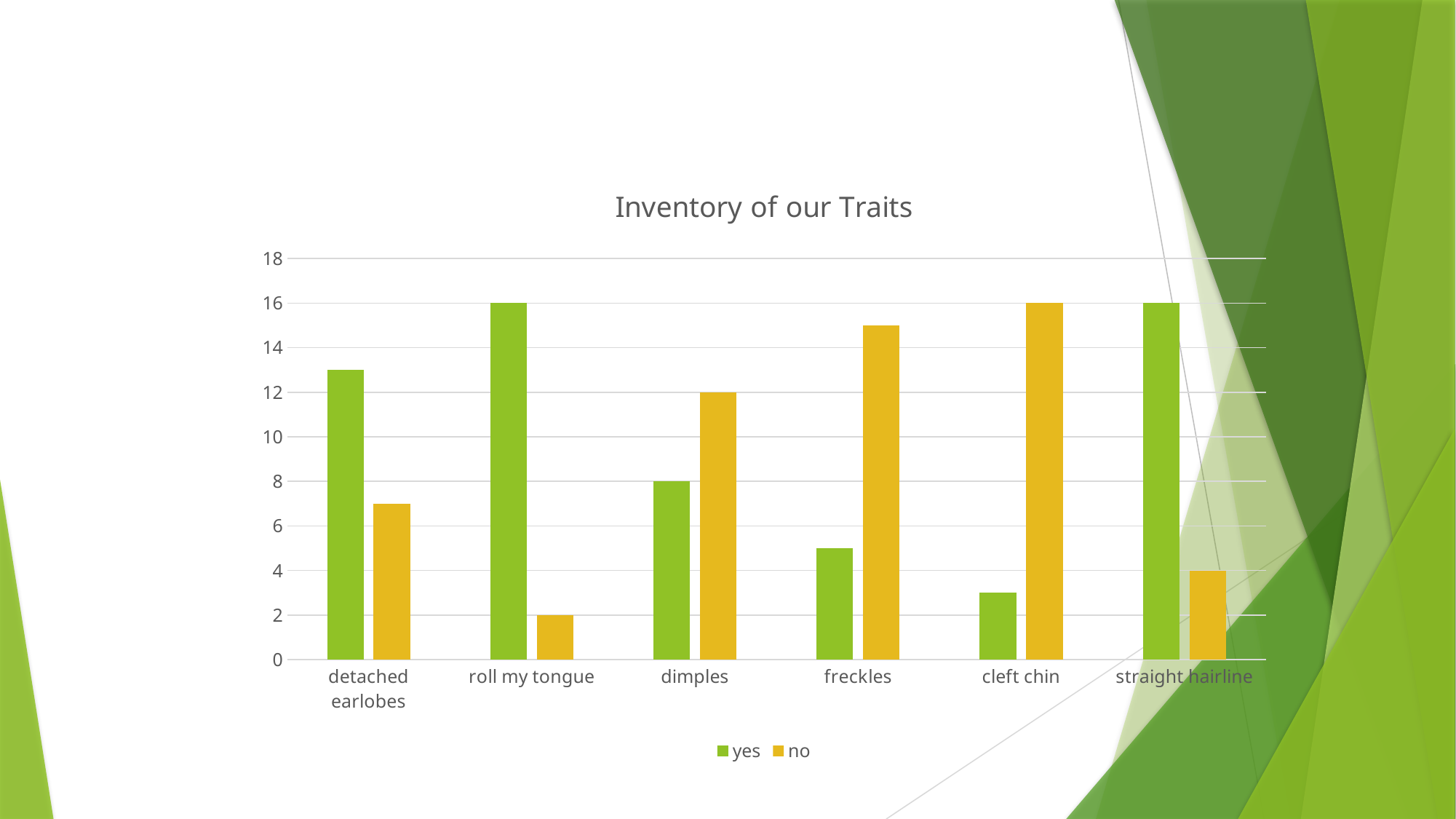
What is the value of the "no" bar for dimples? 12 How many series does the legend list? 2 What is the value of the "yes" bar for roll my tongue? 16 What is the value of the "no" bar for straight hairline? 4 What is the difference between the "yes" and "no" values for roll my tongue? 14 For dimples, which is larger, the "yes" bar or the "no" bar? no Is the "yes" value for cleft chin greater or less than 4? less Which category has the lowest "yes" value? cleft chin Is the "yes" value for detached earlobes greater or less than 12? greater Which category has the lowest "no" value? roll my tongue What is the value of the "yes" bar for dimples? 8 How many trait categories are shown on the x axis? 6